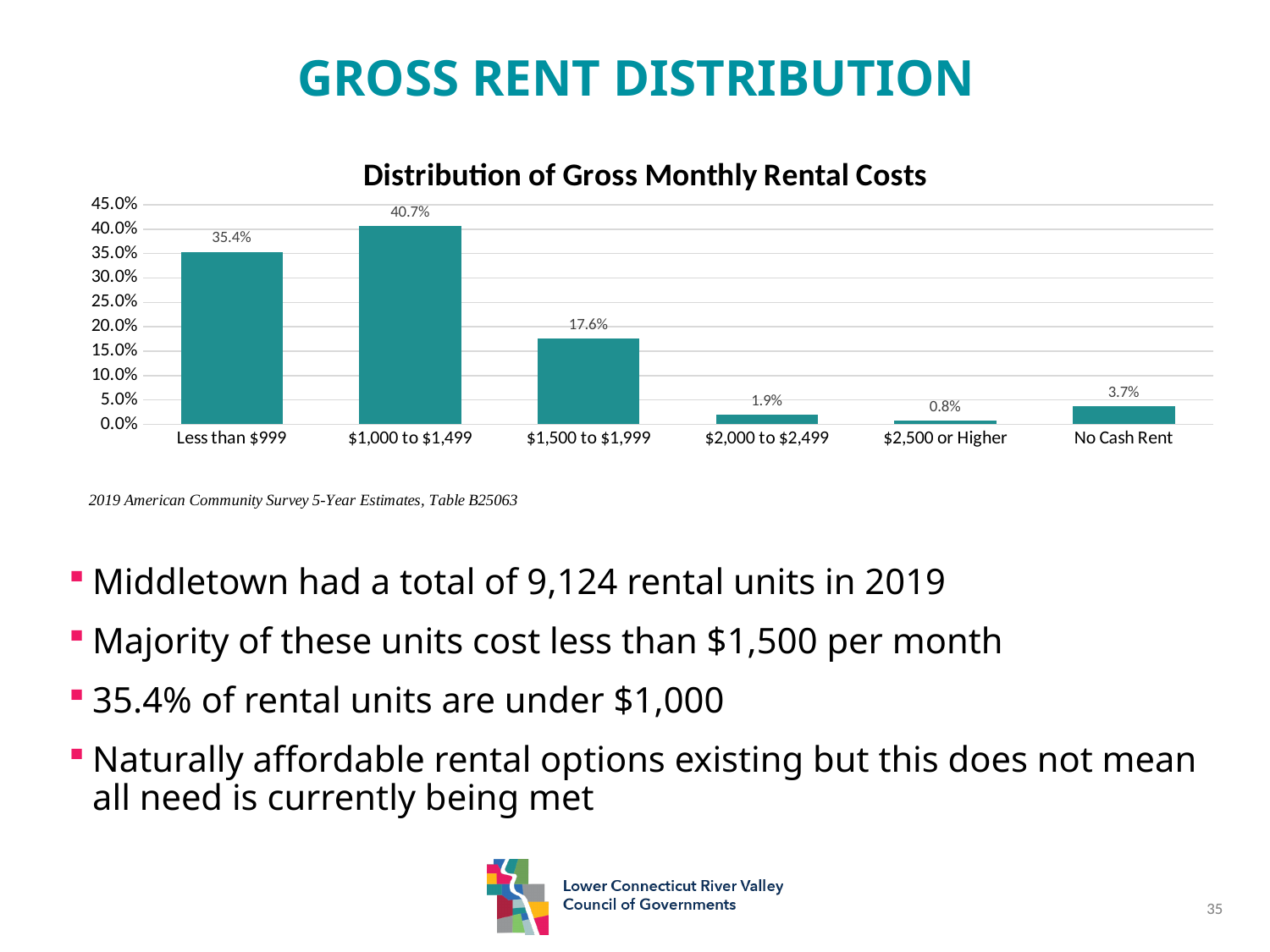
What percentage of rental units cost $1,000 to $1,499 per month? 40.7% Which is larger: the value for $2,000 to $2,499 or the value for No Cash Rent? No Cash Rent How many rent categories are shown on the x axis? 6 What is the value shown for the $1,500 to $1,999 category? 17.6% What is the title of the chart? Distribution of Gross Monthly Rental Costs Which rent category has the lowest percentage? $2,500 or Higher What is the highest value labeled on the y axis? 45.0% Which rent category has the highest percentage? $1,000 to $1,499 What is the difference in percentage points between the $1,000 to $1,499 category and the Less than $999 category? 5.3 Is the value for Less than $999 greater or less than 30.0%? greater What share of units is shown for No Cash Rent? 3.7% What type of chart is used to show the distribution of gross monthly rental costs? Bar chart